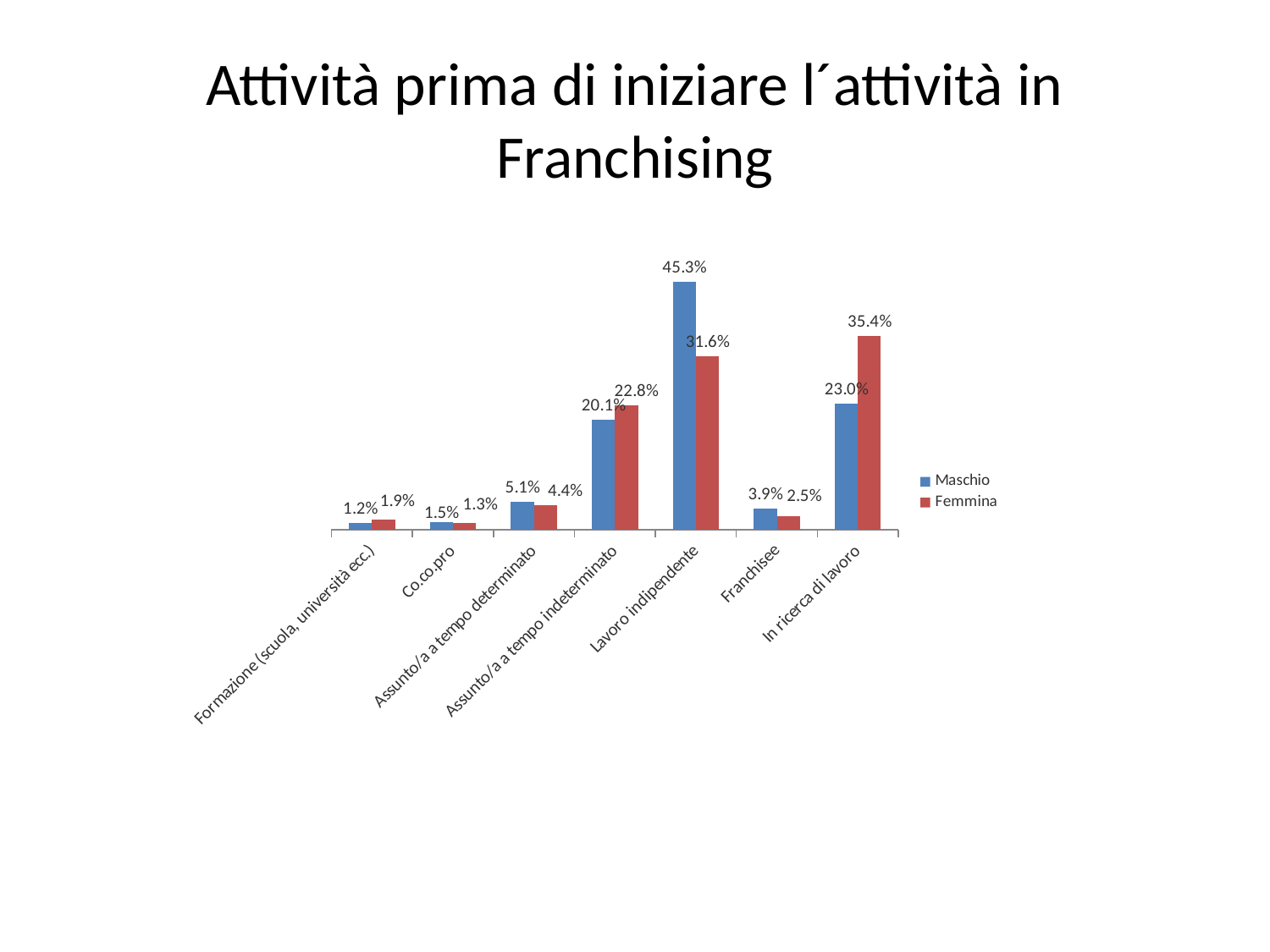
How many categories are shown on the x axis? 7 What is the title of the slide? Attività prima di iniziare l´attività in Franchising How many series does the legend list? 2 For In ricerca di lavoro, which is larger: the Maschio value or the Femmina value? Femmina What is the difference between the Maschio and Femmina values for Lavoro indipendente? 13.7% What kind of chart is shown on the slide? Bar chart What is the Maschio value for Franchisee? 3.9% What is the Femmina value for Assunto/a a tempo indeterminato? 22.8% What is the Maschio value for Lavoro indipendente? 45.3% Which category has the highest Maschio value? Lavoro indipendente What is the Femmina value for In ricerca di lavoro? 35.4% Which category has the lowest Femmina value? Co.co.pro